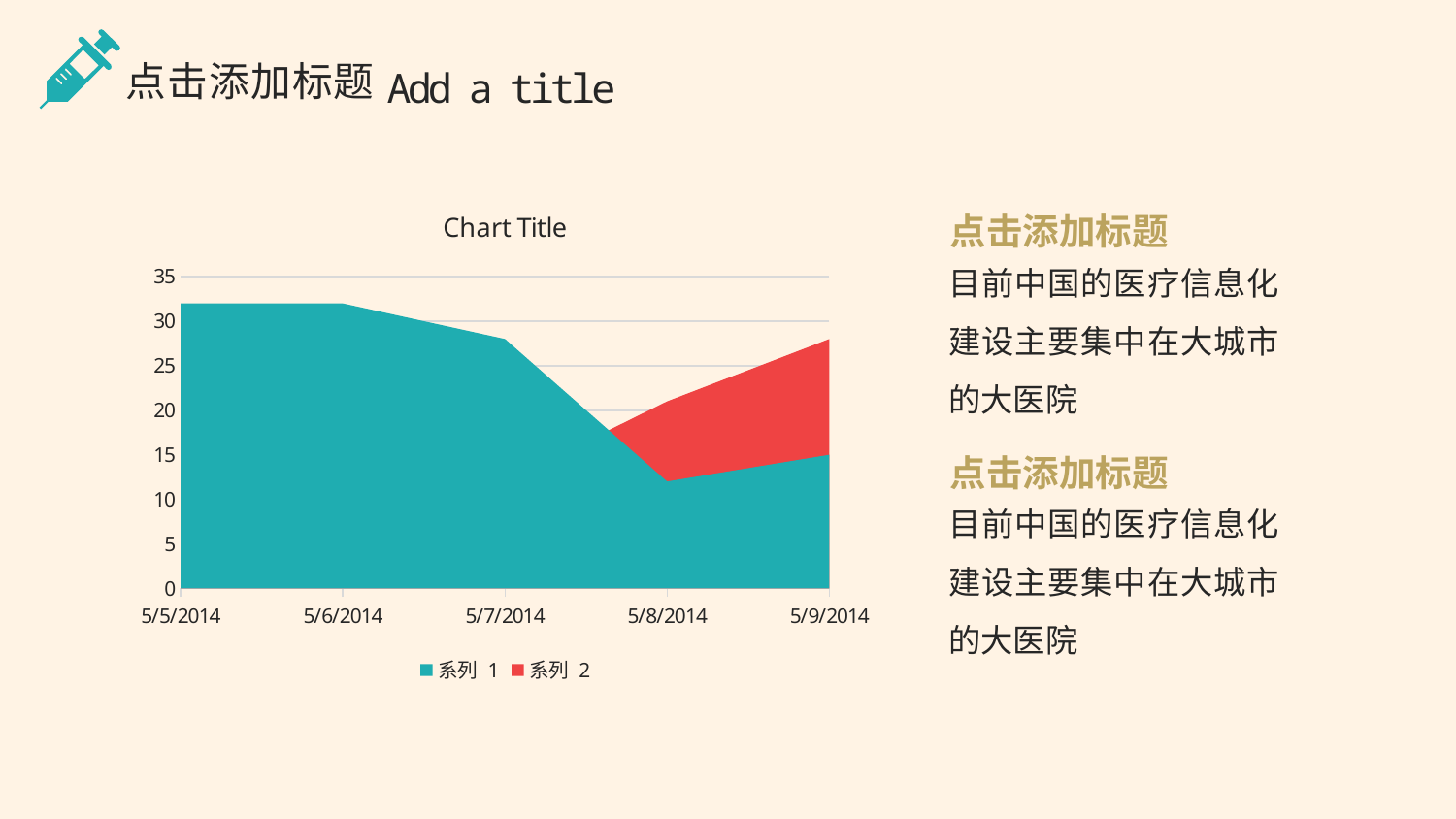
Is the value for 系列 1 on 5/5/2014 greater or less than 30? greater On which date does 系列 1 reach its lowest value? 5/8/2014 What is the title of the chart? Chart Title How many series does the legend list? 2 On 5/9/2014, which series has the larger value, 系列 1 or 系列 2? 系列 2 Is the value for 系列 1 on 5/7/2014 greater or less than 25? greater Is the value for 系列 1 on 5/8/2014 greater or less than 15? less Which colour represents 系列 2 in the chart? red Does the value of 系列 1 rise or fall from 5/6/2014 to 5/8/2014? fall What kind of chart is shown on the slide? area chart How many dates are shown on the x axis? 5